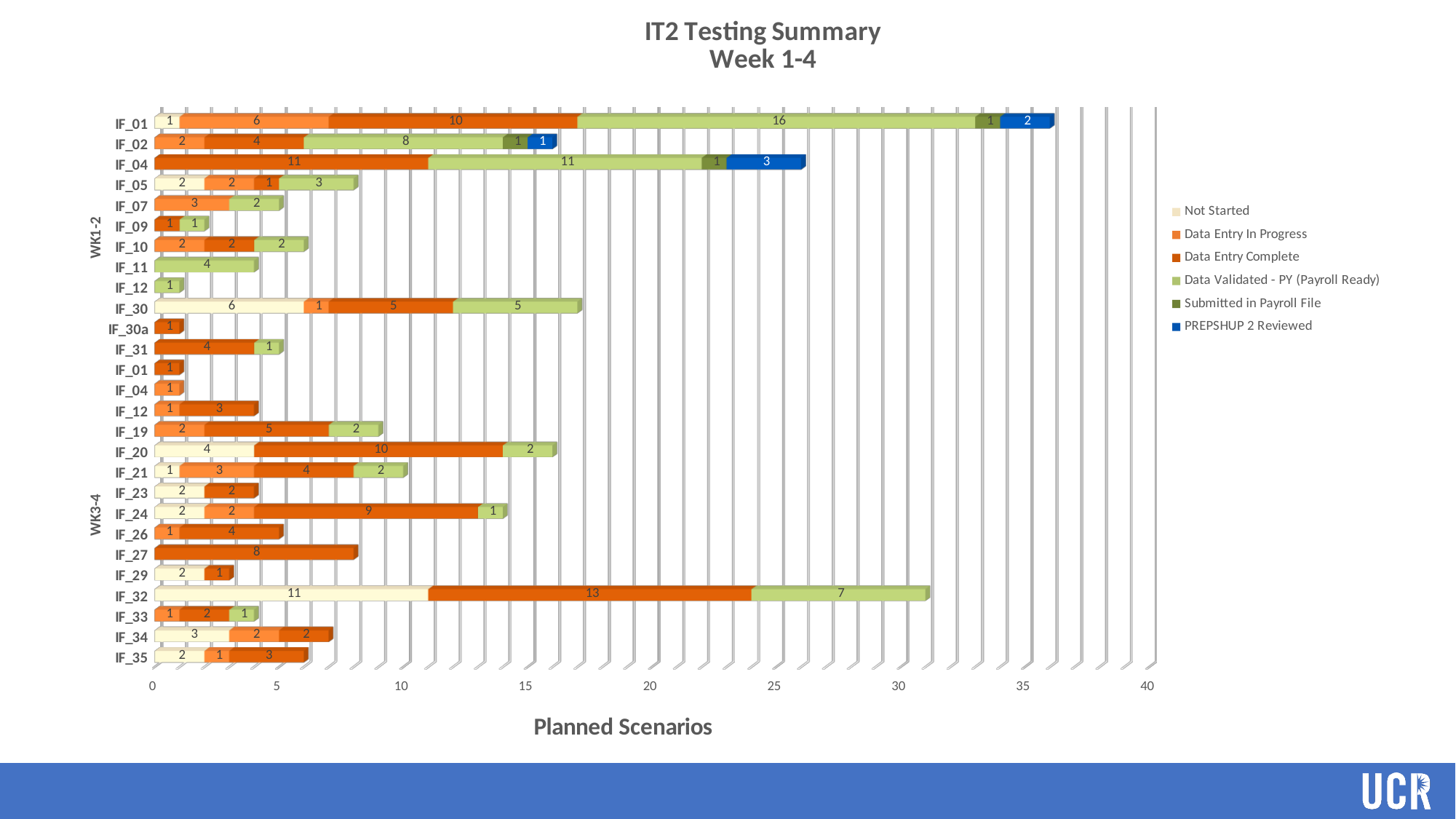
What is the x-axis title of the chart? Planned Scenarios What is the PREPSHUP 2 Reviewed value for IF_04 in the WK1-2 group? 3 What is the Not Started value for IF_32 in the WK3-4 group? 11 How many categories are plotted in the WK3-4 group? 15 Which is larger: the Data Entry Complete value for IF_27 (WK3-4) or for IF_24 (WK3-4)? IF_24 What is the difference between the Data Entry Complete values for IF_32 (WK3-4) and IF_20 (WK3-4)? 3 What is the total of the stacked bar for IF_32 in the WK3-4 group? 31 How many series does the legend list? 6 Which category has the longest stacked bar overall? IF_01 (WK1-2) What is the total of the stacked bar for IF_01 in the WK1-2 group? 36 What kind of chart is shown on the slide? Stacked bar chart What is the Data Validated - PY (Payroll Ready) value for IF_01 in the WK1-2 group? 16